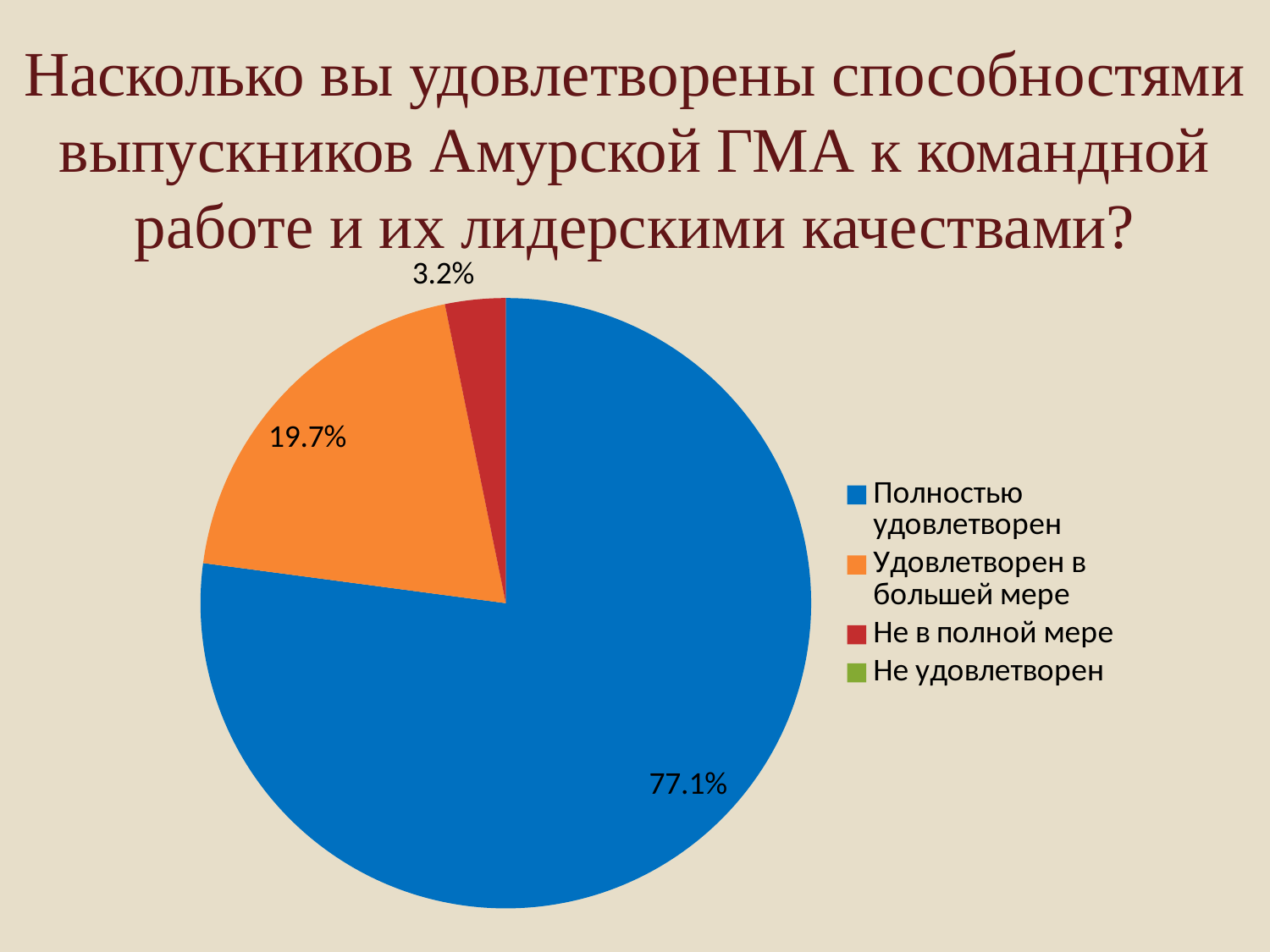
How many entries does the legend list? 4 What kind of chart is shown on the slide? Pie chart Which response category has the largest share of the pie? Полностью удовлетворен What share of respondents answered "Полностью удовлетворен"? 77.1% What is the difference in percentage points between "Полностью удовлетворен" and "Удовлетворен в большей мере"? 57.4 What is the difference in percentage points between "Удовлетворен в большей мере" and "Не в полной мере"? 16.5 What share of respondents answered "Удовлетворен в большей мере"? 19.7% What share of respondents answered "Не в полной мере"? 3.2% How many slices have a percentage label printed on the pie? 3 Which is larger: the share for "Удовлетворен в большей мере" or the share for "Не в полной мере"? Удовлетворен в большей мере Which labelled slice of the pie is the smallest? Не в полной мере What colour is the slice for "Полностью удовлетворен"? Blue